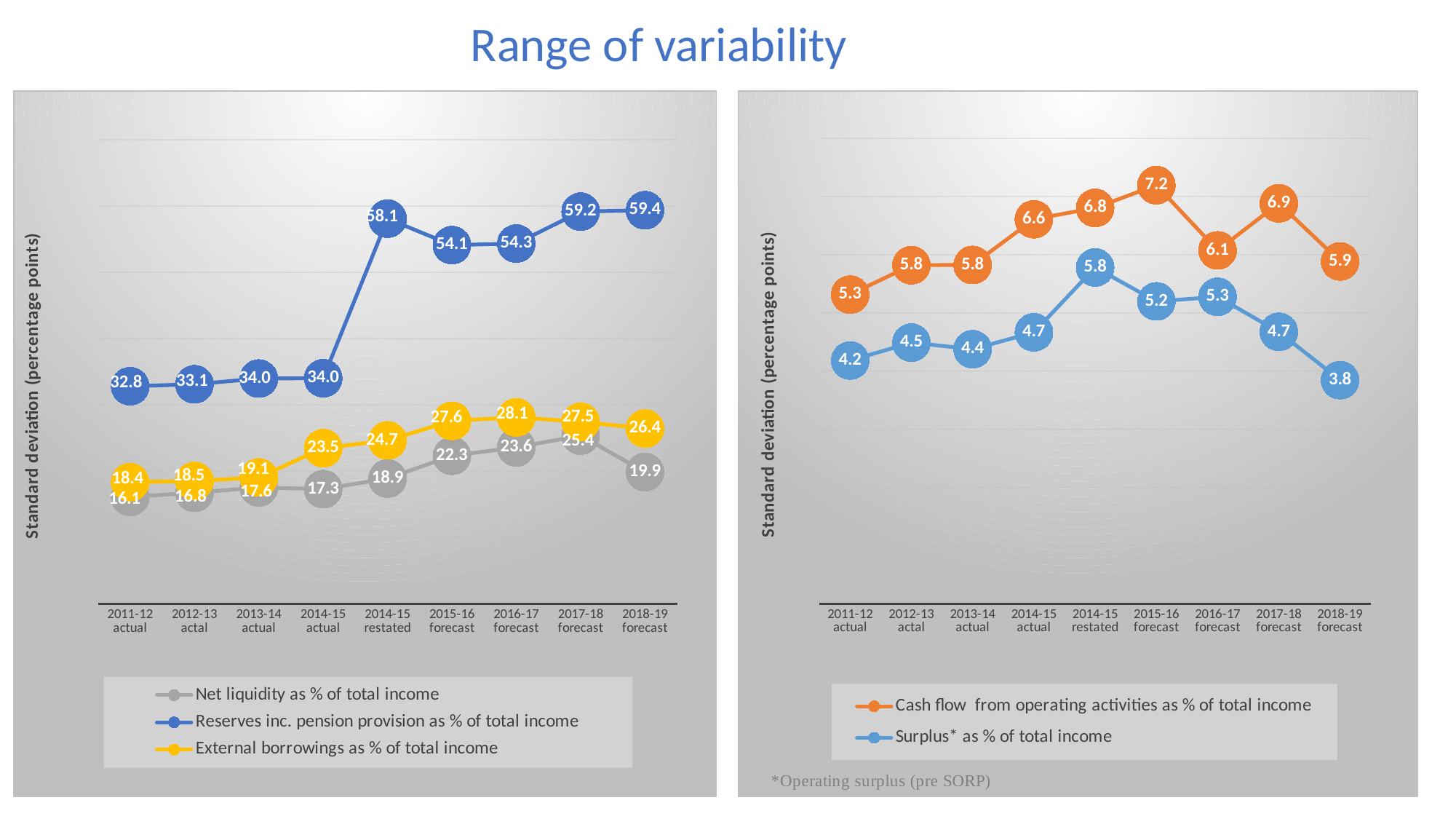
In the left chart, how many series does the legend list? 3 In the left chart, what is the value for Reserves inc. pension provision as % of total income in 2014-15 restated? 58.1 In the right chart, what is the value for Cash flow from operating activities as % of total income in 2015-16 forecast? 7.2 What kind of chart is the right chart? Line chart In the right chart, which is larger in 2016-17 forecast: Cash flow from operating activities or Surplus*? Cash flow from operating activities In the right chart, in which period is Surplus* as % of total income highest? 2014-15 restated In the right chart, what is the value for Surplus* as % of total income in 2018-19 forecast? 3.8 In the left chart, in which period is Reserves inc. pension provision as % of total income highest? 2018-19 forecast In the left chart, what is the difference between the Reserves inc. pension provision value in 2014-15 restated and in 2014-15 actual? 24.1 In the left chart, what is the value for External borrowings as % of total income in 2016-17 forecast? 28.1 In the right chart, what is the difference between Cash flow from operating activities and Surplus* in 2011-12 actual? 1.1 In the left chart, what is the value for Net liquidity as % of total income in 2011-12 actual? 16.1